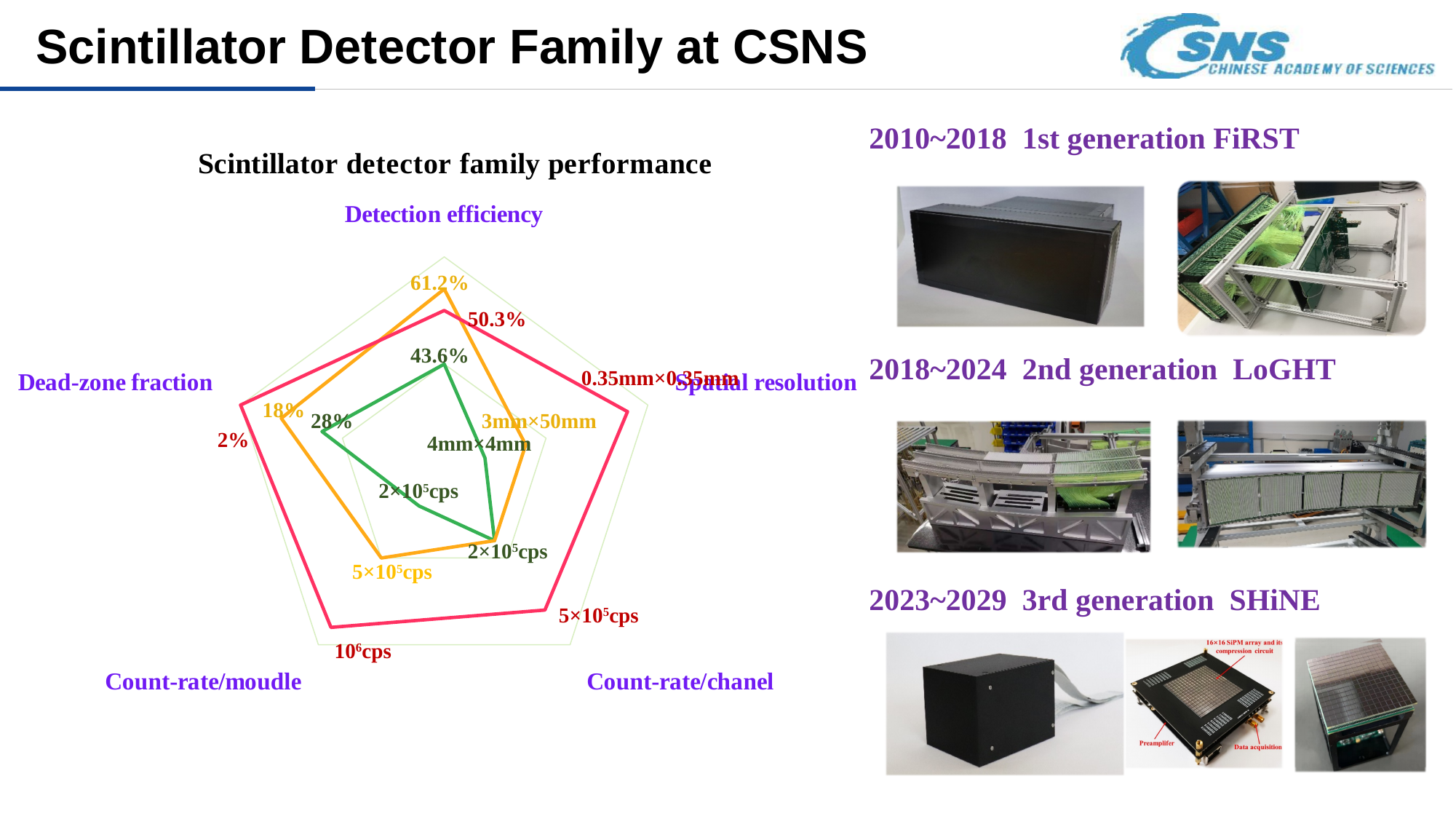
What is the Detection efficiency value labelled on the red series? 50.3% What is the difference between the orange and red Detection efficiency values? 10.9% How many data series (coloured lines) are plotted on the radar chart? 3 Which is larger, the Dead-zone fraction of the green series or of the orange series? Green (28%) What Dead-zone fraction is labelled on the red series? 2% What is the Detection efficiency value labelled on the green series? 43.6% What is the Detection efficiency value labelled on the orange series? 61.2% What Count-rate/moudle value is labelled on the red series? 10⁶cps How many axes (performance categories) does the radar chart have? 5 What Spatial resolution is labelled on the red series? 0.35mm×0.35mm What kind of chart is shown under the title "Scintillator detector family performance"? Radar chart Which series has the highest Detection efficiency value? Orange (61.2%)